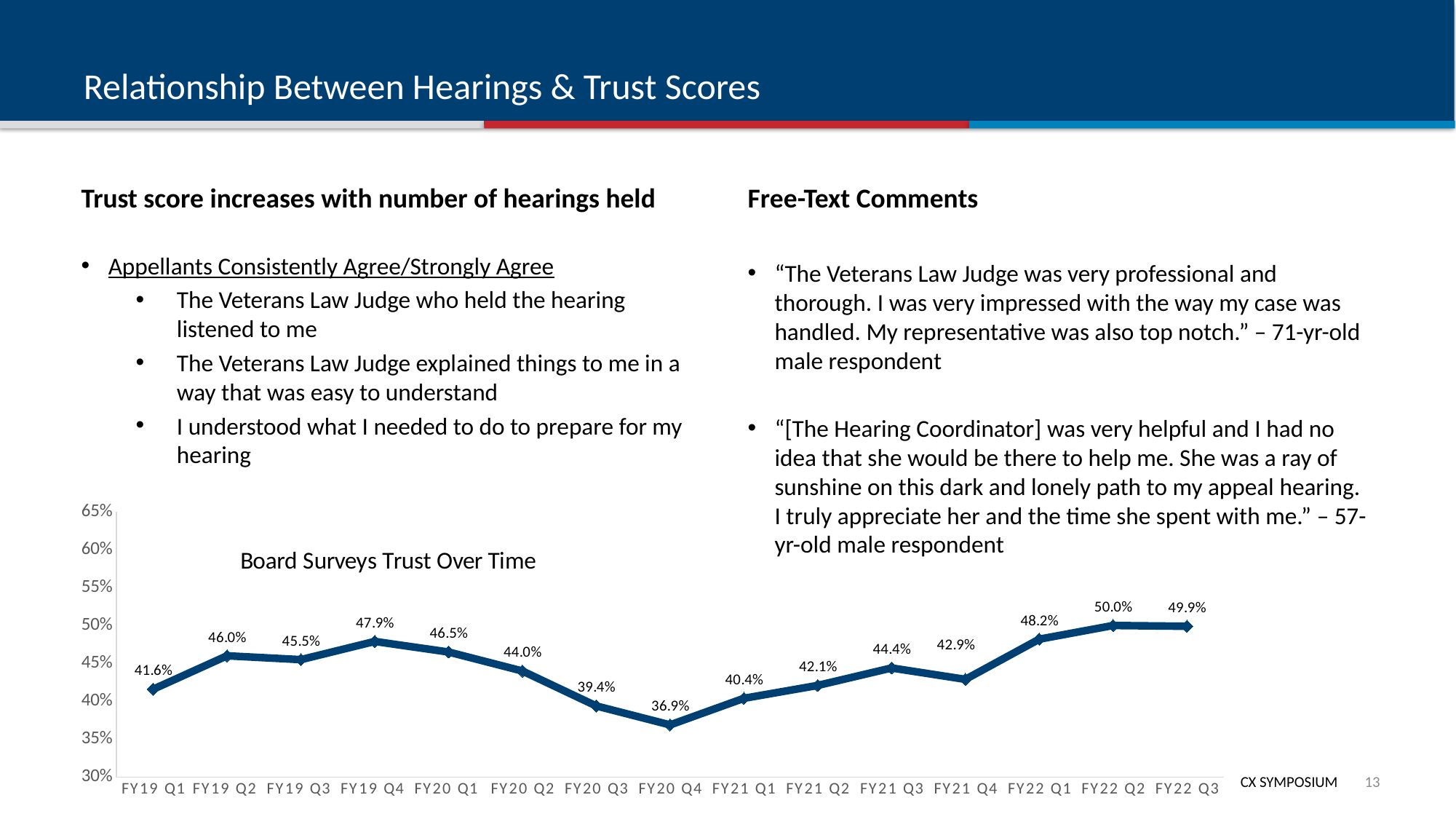
What is the trust score for FY22 Q1 in the Board Surveys Trust Over Time chart? 48.2% Which quarter has the lowest trust score in the Board Surveys Trust Over Time chart? FY20 Q4 What is the trust score for FY19 Q1 in the Board Surveys Trust Over Time chart? 41.6% In the Board Surveys Trust Over Time chart, is the trust score for FY20 Q4 greater or less than 40%? less In the Board Surveys Trust Over Time chart, which is higher: the trust score for FY19 Q4 or FY20 Q1? FY19 Q4 How many quarters are plotted in the Board Surveys Trust Over Time chart? 15 What is the trust score for FY20 Q4 in the Board Surveys Trust Over Time chart? 36.9% Which quarter has the highest trust score in the Board Surveys Trust Over Time chart? FY22 Q2 What kind of chart is the Board Surveys Trust Over Time chart? line chart What is the difference in percentage points between the trust score for FY22 Q2 and FY19 Q1 in the Board Surveys Trust Over Time chart? 8.4 percentage points In the Board Surveys Trust Over Time chart, does the trust score rise or fall from FY20 Q4 to FY22 Q2? rise What is the title of the chart on the slide? Board Surveys Trust Over Time